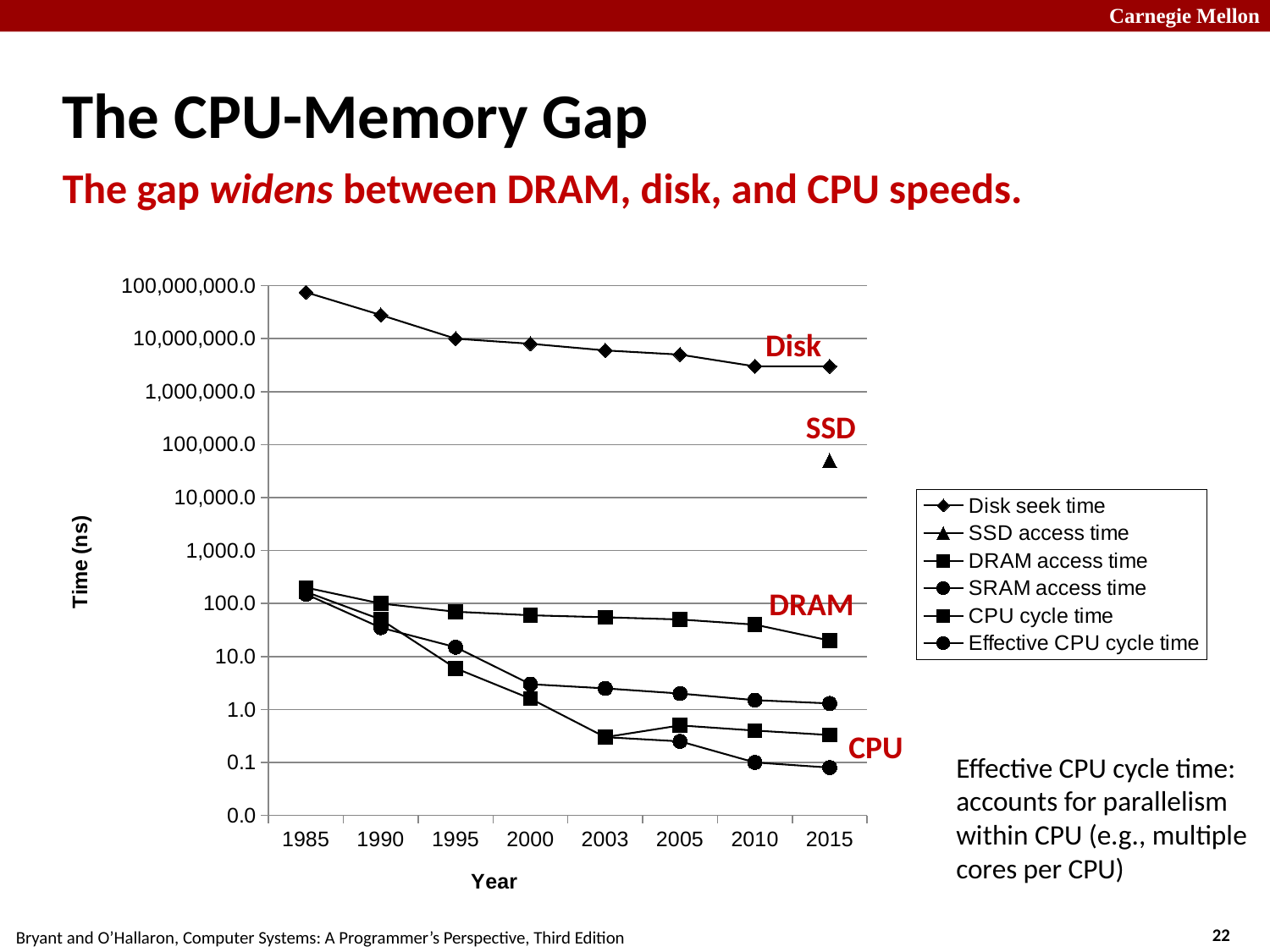
Is the DRAM access time in 2015 greater or less than 100.0? less In 2015, which is larger: Disk seek time or DRAM access time? Disk seek time What is the title of the x axis? Year How many series does the legend list? 6 What kind of chart is shown on the slide? line chart What is the title of the y axis? Time (ns) How many years are plotted along the x axis? 8 Does the Disk seek time rise or fall from 1985 to 2015? fall Is the Disk seek time in 1985 greater or less than 10,000,000.0? greater Is the SSD access time in 2015 greater or less than 100,000.0? less Which series has the highest value in 2015? Disk seek time Which series has the lowest value in 2015? Effective CPU cycle time